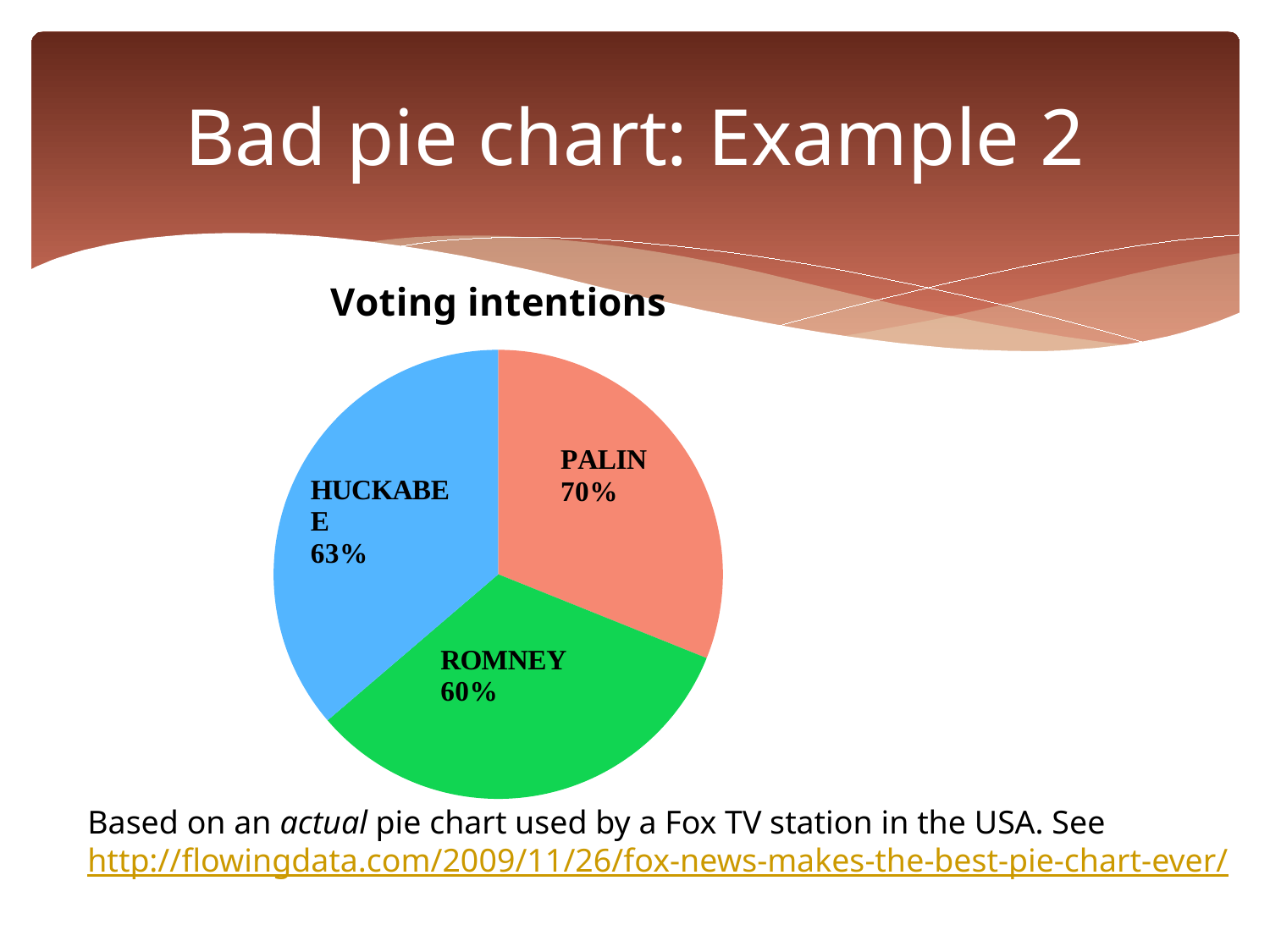
What is the title of the chart? Voting intentions What percentage is shown for PALIN? 70% What colour is the ROMNEY slice? Green What percentage is shown for HUCKABEE? 63% What is the difference between the percentages shown for PALIN and HUCKABEE? 7% Which candidate has the lowest percentage in the pie chart? ROMNEY What is the difference between the percentages shown for HUCKABEE and ROMNEY? 3% Which candidate has the highest percentage in the pie chart? PALIN How many slices does the pie chart have? 3 What type of chart is shown on the slide? Pie chart What percentage is shown for ROMNEY? 60% Which is larger, the percentage for PALIN or the percentage for ROMNEY? PALIN